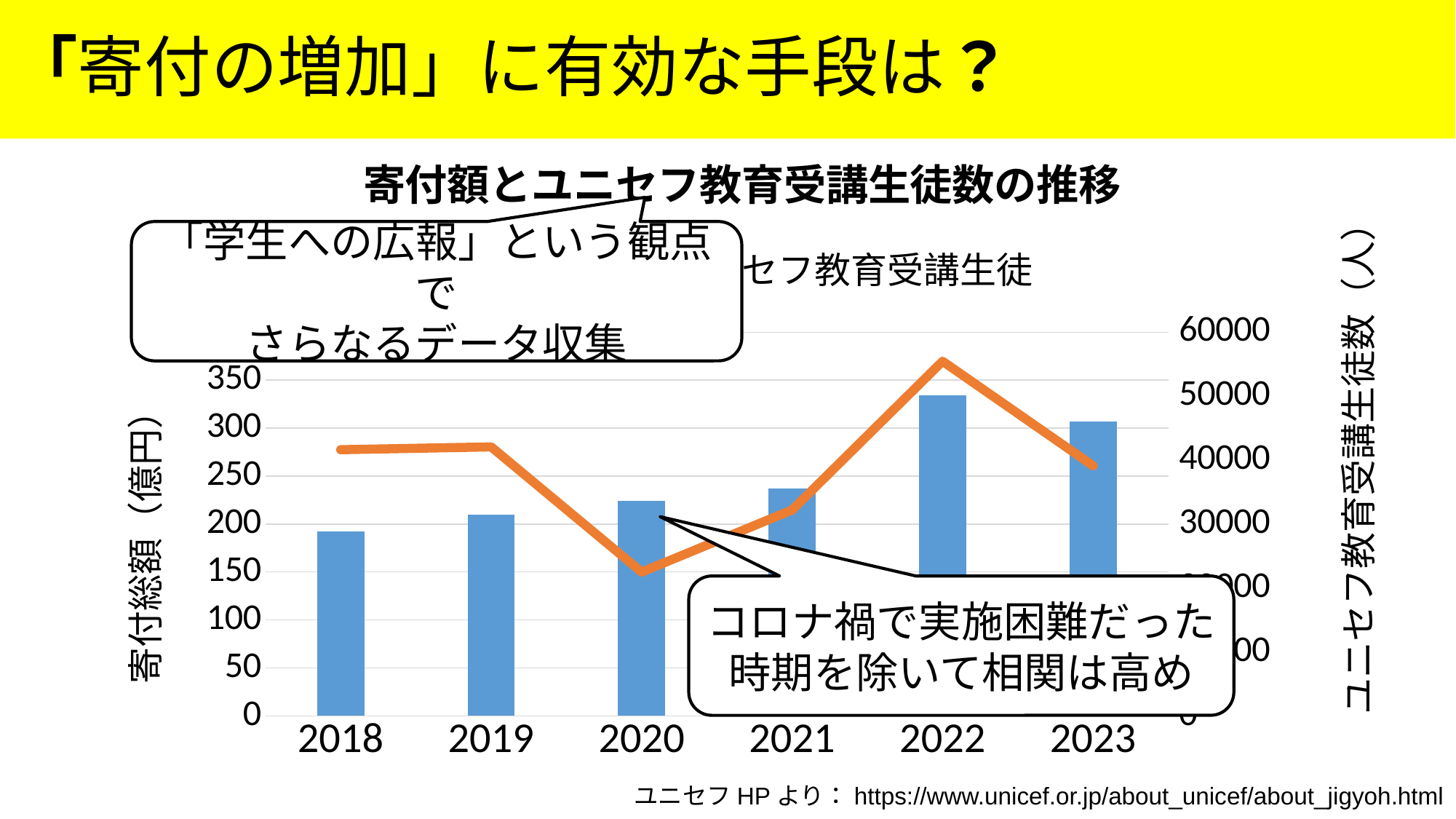
What kind of chart is shown on the slide? A combined bar and line chart In which year is the donation total (bar) the highest? 2022 Is the donation total for 2022 greater or less than 300 億円? greater What is the title of the chart? 寄付額とユニセフ教育受講生徒数の推移 Is the number of UNICEF education students in 2020 greater or less than 30000? less Is the donation total for 2018 greater or less than 200 億円? less Which year has a larger donation total, 2022 or 2023? 2022 How many years are shown on the x axis of the chart? 6 In which year is the donation total (bar) the lowest? 2018 Do the donation totals (bars) rise or fall from 2018 to 2022? rise In which year is the number of UNICEF education students (line) the lowest? 2020 In which year is the number of UNICEF education students (line) the highest? 2022